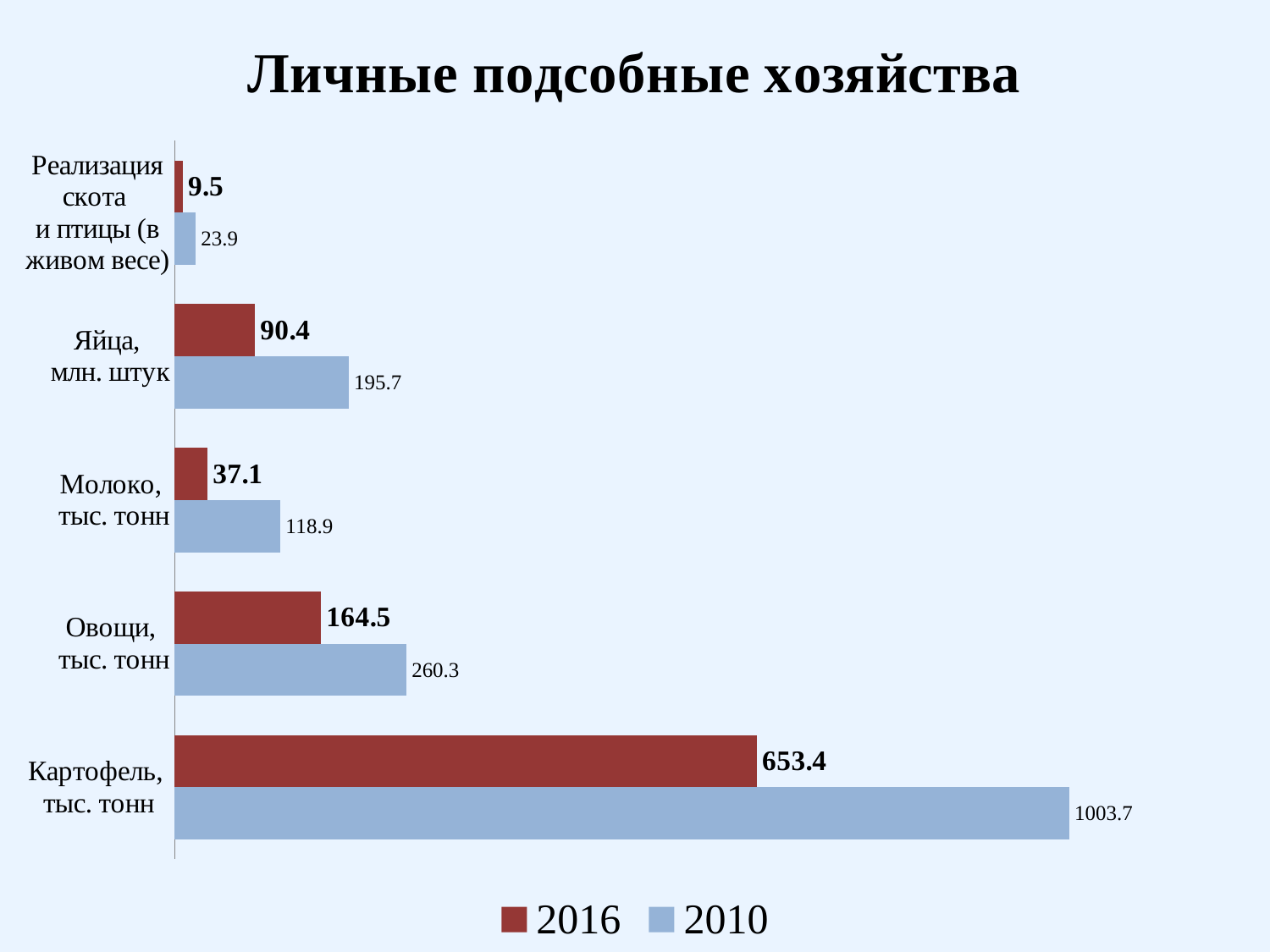
How many series does the legend list? 2 Which is larger for Молоко, тыс. тонн: the 2016 value or the 2010 value? 2010 Which category has the lowest 2016 value? Реализация скота и птицы (в живом весе) Which category has the highest 2010 value? Картофель, тыс. тонн What is the difference between the 2010 and 2016 values for Картофель, тыс. тонн? 350.3 How many categories are shown on the chart? 5 What kind of chart is shown on the slide? Bar chart What is the 2016 value for Реализация скота и птицы (в живом весе)? 9.5 What is the difference between the 2010 and 2016 values for Овощи, тыс. тонн? 95.8 What is the 2010 value for Молоко, тыс. тонн? 118.9 What is the 2010 value for Яйца, млн. штук? 195.7 What is the 2016 value for Картофель, тыс. тонн? 653.4